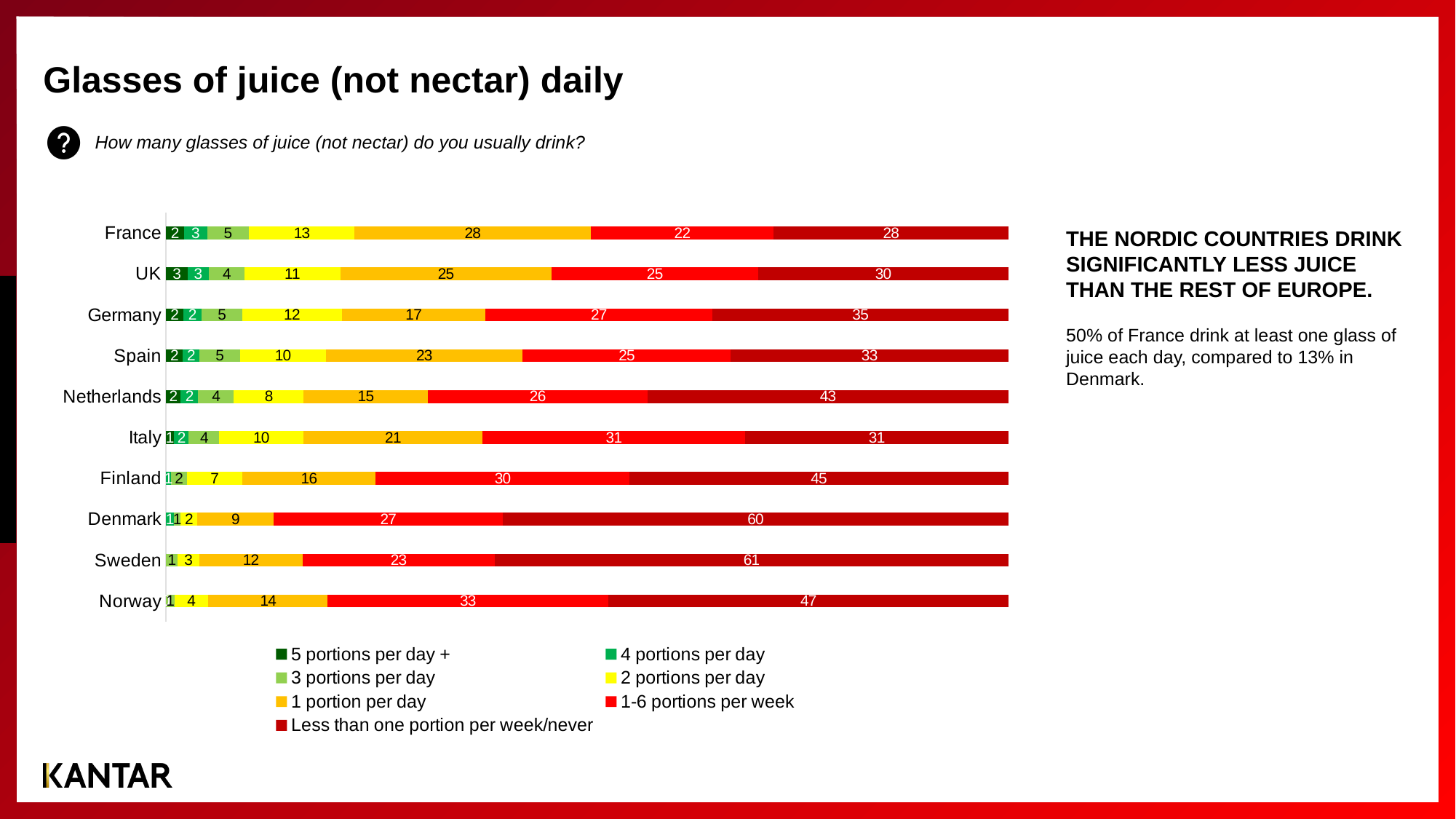
Which country has the lowest value in the 'Less than one portion per week/never' series? France Which has the larger value in the '1-6 portions per week' series, Germany or Spain? Germany What kind of chart is shown on the slide? Stacked bar chart What colour represents '2 portions per day' in the legend? Yellow What is the difference between Denmark and France in the 'Less than one portion per week/never' series? 32 How many countries are listed on the chart? 10 What is the value for Norway in the '1-6 portions per week' series? 33 What is the value for France in the '1 portion per day' series? 28 Which country has the highest value in the '1 portion per day' series? France How many series does the legend list? 7 What is the value for the Netherlands in the '2 portions per day' series? 8 What is the value for Sweden in the 'Less than one portion per week/never' series? 61